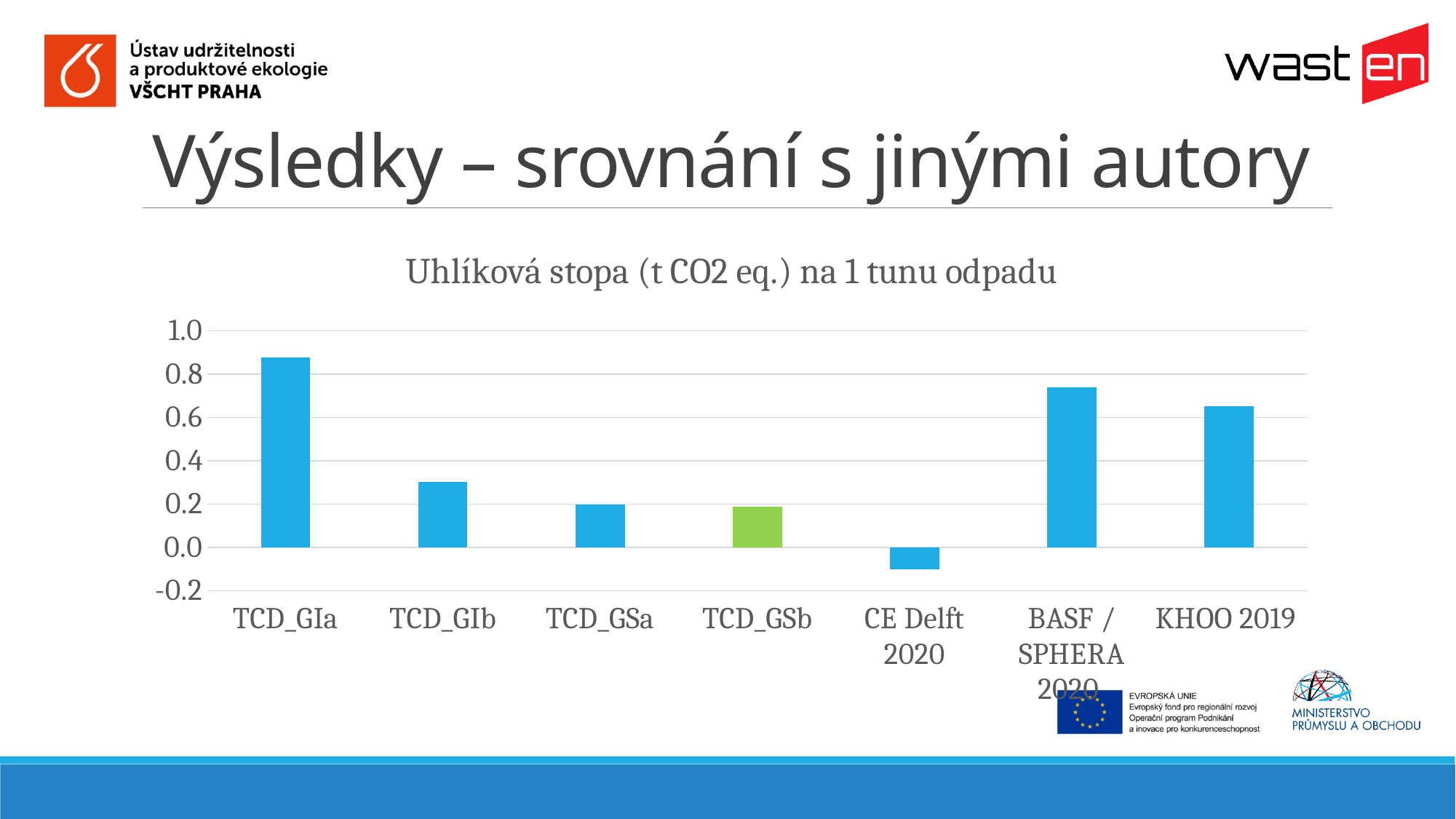
How many categories are shown on the x axis of the chart? 7 Which is larger, the value for TCD_GIb or the value for TCD_GSa? TCD_GIb Which category's bar is coloured green rather than blue? TCD_GSb Is the value for CE Delft 2020 greater or less than 0.0? less Is the value for TCD_GSa greater or less than 0.4? less Which is larger, the value for TCD_GIa or the value for BASF / SPHERA 2020? TCD_GIa Is the value for BASF / SPHERA 2020 greater or less than 0.6? greater What kind of chart is shown on the slide? bar chart Which category has the highest value in the chart? TCD_GIa What is the title of the chart? Uhlíková stopa (t CO2 eq.) na 1 tunu odpadu Which category has the lowest value in the chart? CE Delft 2020